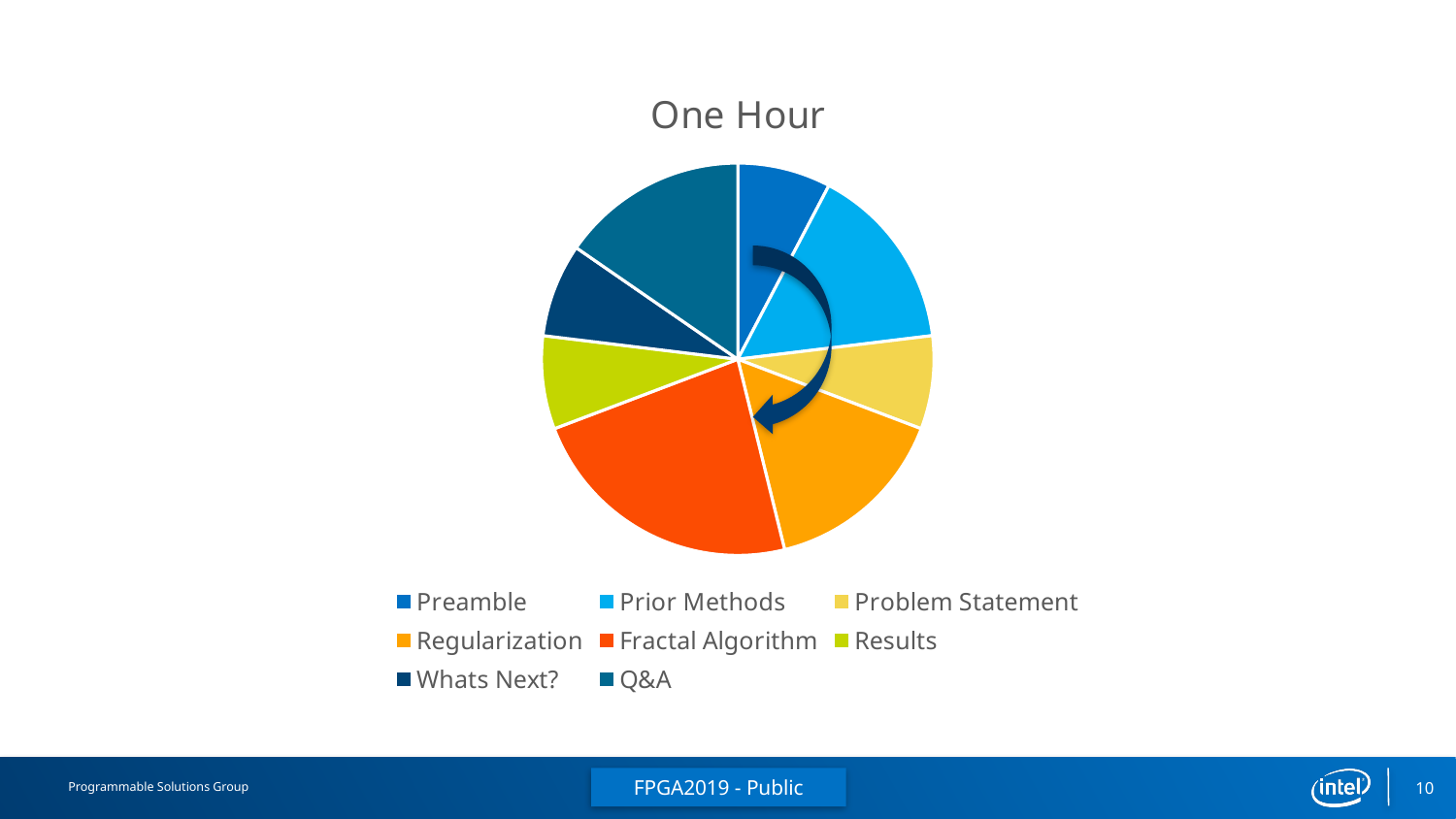
Which slice is larger, Fractal Algorithm or Preamble? Fractal Algorithm Which slice is larger, Prior Methods or Problem Statement? Prior Methods What kind of chart is shown on the slide? pie chart What is the title of the chart? One Hour How many entries does the legend list? 8 Which slice is larger, Q&A or Results? Q&A Which legend entry is shown in orange-red? Fractal Algorithm How many slices does the pie chart have? 8 Which slice of the pie chart is the largest? Fractal Algorithm